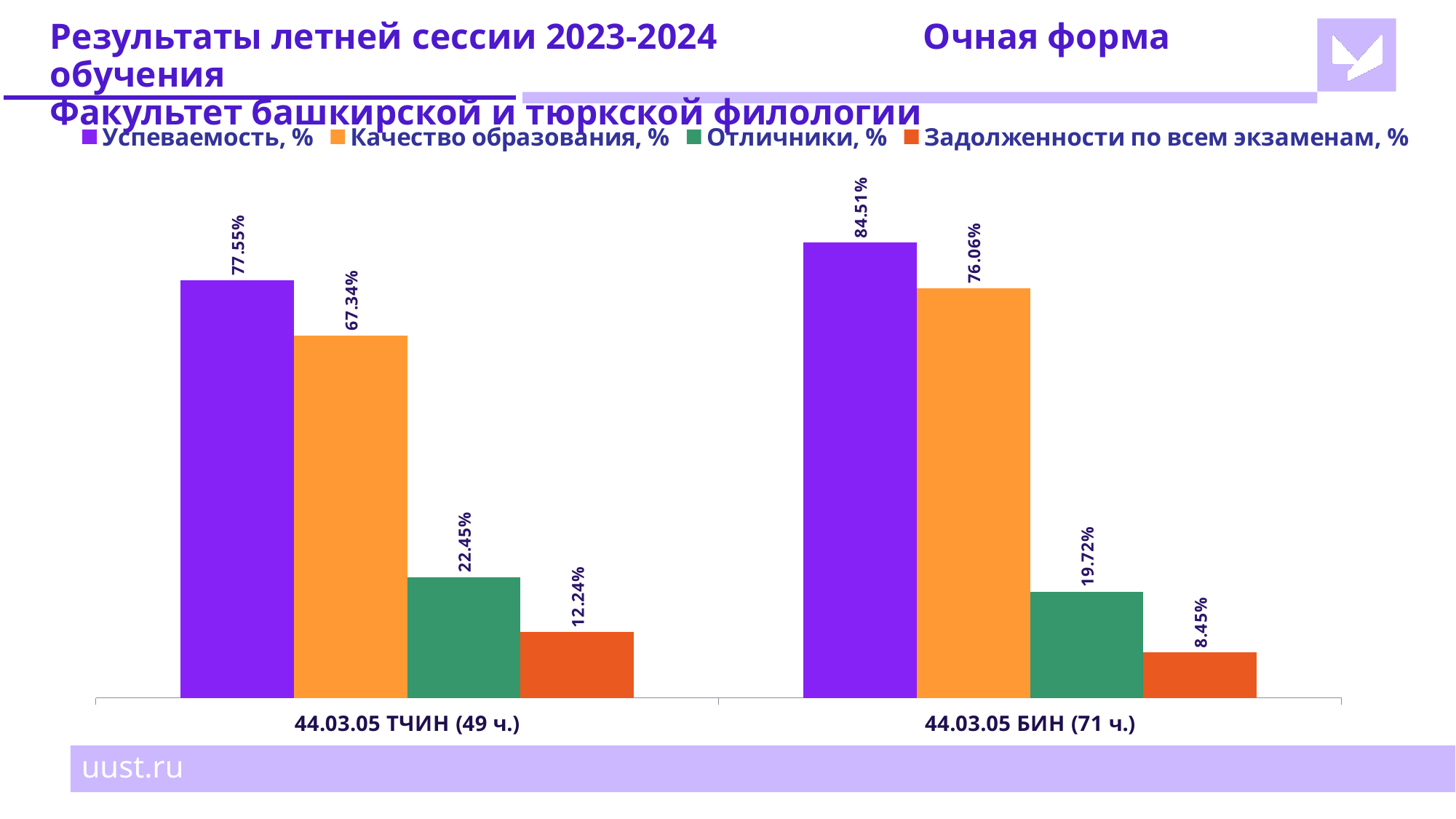
Which category has the lower value for Задолженности по всем экзаменам, %? 44.03.05 БИН (71 ч.) What is the value of Задолженности по всем экзаменам, % for 44.03.05 БИН (71 ч.)? 8.45% What is the value of Качество образования, % for 44.03.05 БИН (71 ч.)? 76.06% Which category has the higher value for Успеваемость, %? 44.03.05 БИН (71 ч.) Which is larger: Качество образования, % for 44.03.05 ТЧИН (49 ч.) or for 44.03.05 БИН (71 ч.)? 44.03.05 БИН (71 ч.) What is the value of Успеваемость, % for 44.03.05 ТЧИН (49 ч.)? 77.55% What is the difference in Отличники, % between 44.03.05 ТЧИН (49 ч.) and 44.03.05 БИН (71 ч.)? 2.73% How many series does the legend list? 4 How many categories are shown on the x axis of the chart? 2 What kind of chart is shown on the slide? Bar chart What is the difference in Успеваемость, % between 44.03.05 БИН (71 ч.) and 44.03.05 ТЧИН (49 ч.)? 6.96% What is the value of Отличники, % for 44.03.05 ТЧИН (49 ч.)? 22.45%